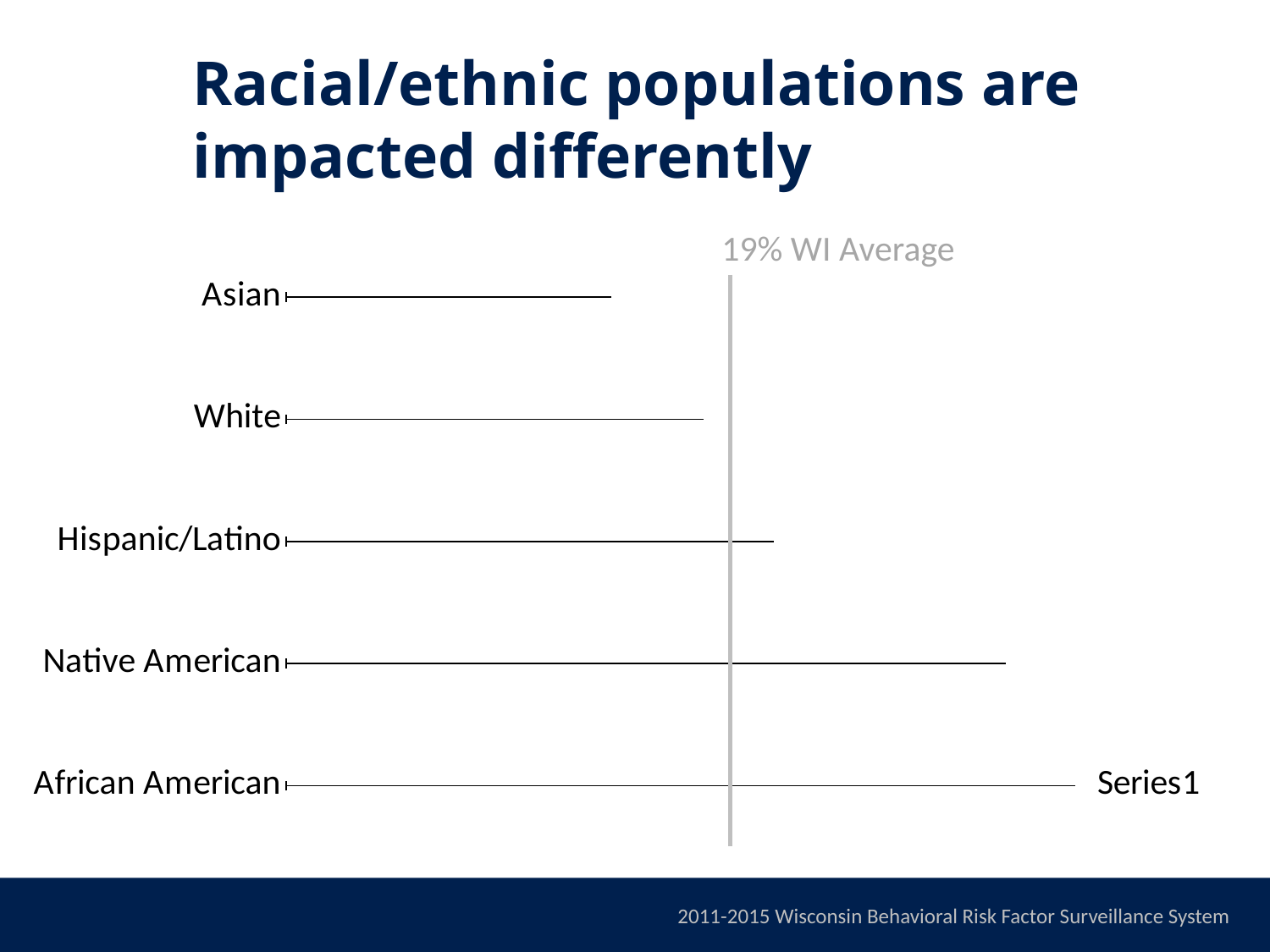
What kind of chart is shown on the slide? bar chart Is the value for African American greater or less than the 19% WI Average line? greater Which category has the longest bar in the chart? African American Is the value for Native American greater or less than the 19% WI Average line? greater Is the value for White greater or less than the 19% WI Average line? less How many racial/ethnic categories are plotted in the chart? 5 What value does the vertical reference line in the chart represent? 19% WI Average What is the title of the slide containing the chart? Racial/ethnic populations are impacted differently Which has the larger value, Native American or White? Native American Which has the larger value, Asian or Hispanic/Latino? Hispanic/Latino Which category has the shortest bar in the chart? Asian